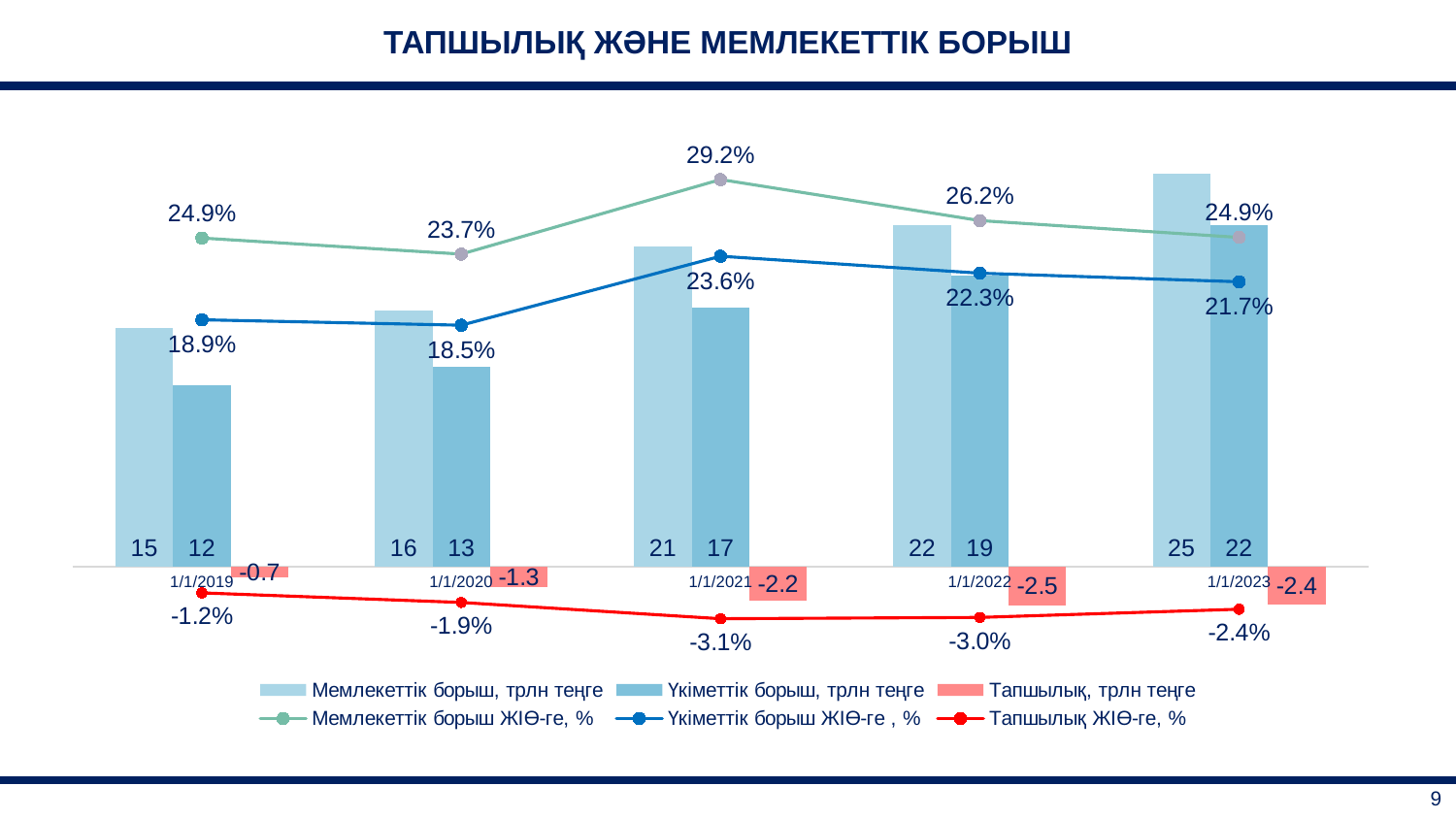
How many dates are shown on the x axis? 5 What is the value of Мемлекеттік борыш ЖІӨ-ге, % for 1/1/2020? 23.7% Does Мемлекеттік борыш, трлн теңге rise or fall from 1/1/2019 to 1/1/2023? rise In which year is Мемлекеттік борыш ЖІӨ-ге, % highest? 1/1/2021 How many series does the legend list? 6 What is the value of Тапшылық, трлн теңге for 1/1/2019? -0.7 What is the value of Мемлекеттік борыш, трлн теңге for 1/1/2021? 21 Which is larger: Үкіметтік борыш ЖІӨ-ге, % for 1/1/2021 or for 1/1/2023? 1/1/2021 What is the difference between Мемлекеттік борыш, трлн теңге and Үкіметтік борыш, трлн теңге for 1/1/2022? 3 What is the value of Үкіметтік борыш, трлн теңге for 1/1/2023? 22 What is the value of Тапшылық ЖІӨ-ге, % for 1/1/2022? -3.0% In which year is Үкіметтік борыш ЖІӨ-ге, % lowest? 1/1/2020